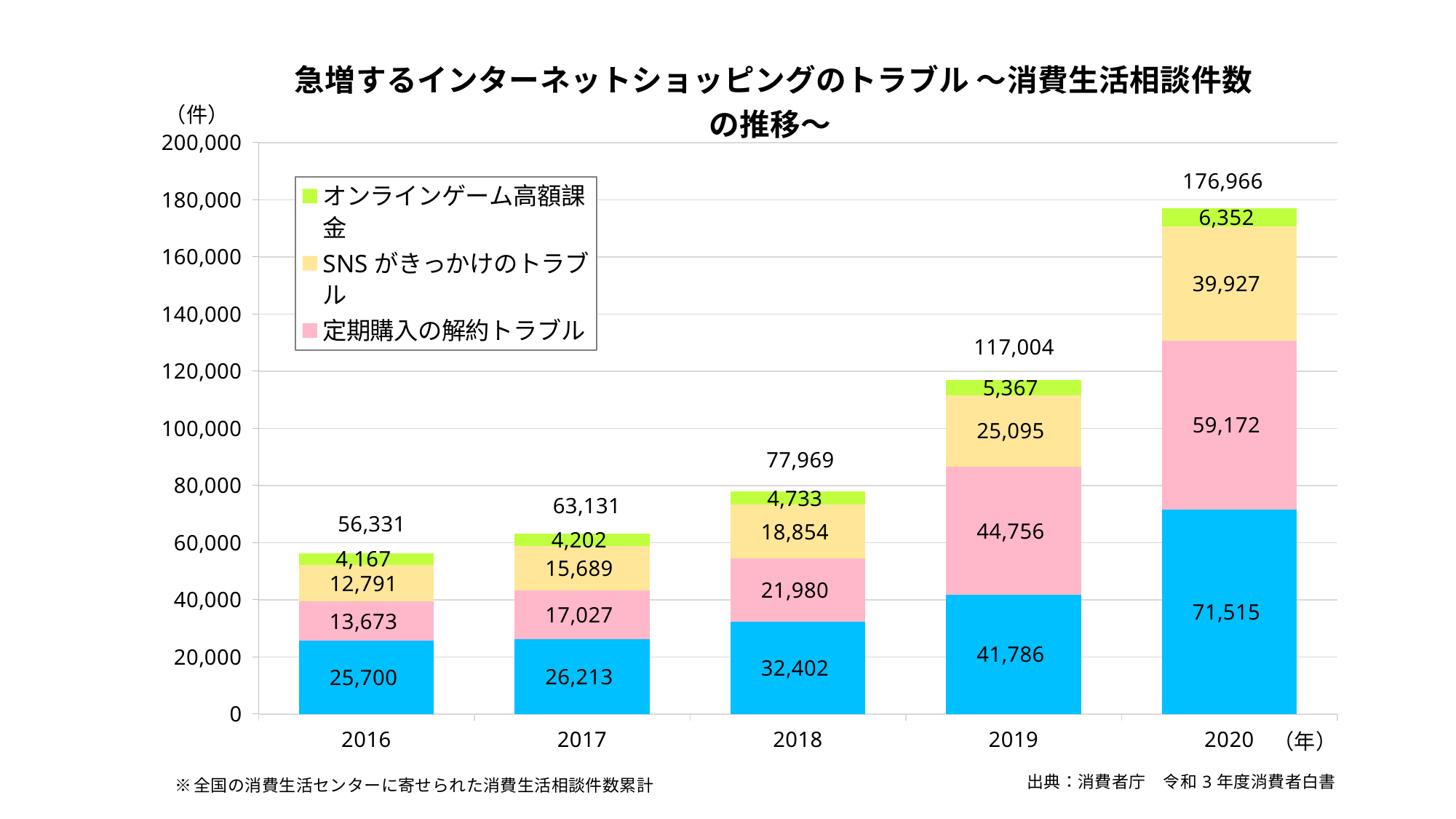
Which year has the highest total number of consultations? 2020 What is the value for SNSがきっかけのトラブル in 2018? 18,854 What is the value for オンラインゲーム高額課金 in 2016? 4,167 What is the total number of consultations shown above the 2020 bar? 176,966 How many years are shown on the x axis? 5 What is the value for 定期購入の解約トラブル in 2019? 44,756 What kind of chart is shown on the slide? Stacked bar chart Which is larger: the value for 定期購入の解約トラブル in 2017 or the value for SNSがきっかけのトラブル in 2017? 定期購入の解約トラブル in 2017 Which year has the lowest total number of consultations? 2016 What is the difference between the total for 2020 and the total for 2019? 59,962 How many series does the legend list? 3 Do the total consultation numbers rise or fall from 2016 to 2020? Rise